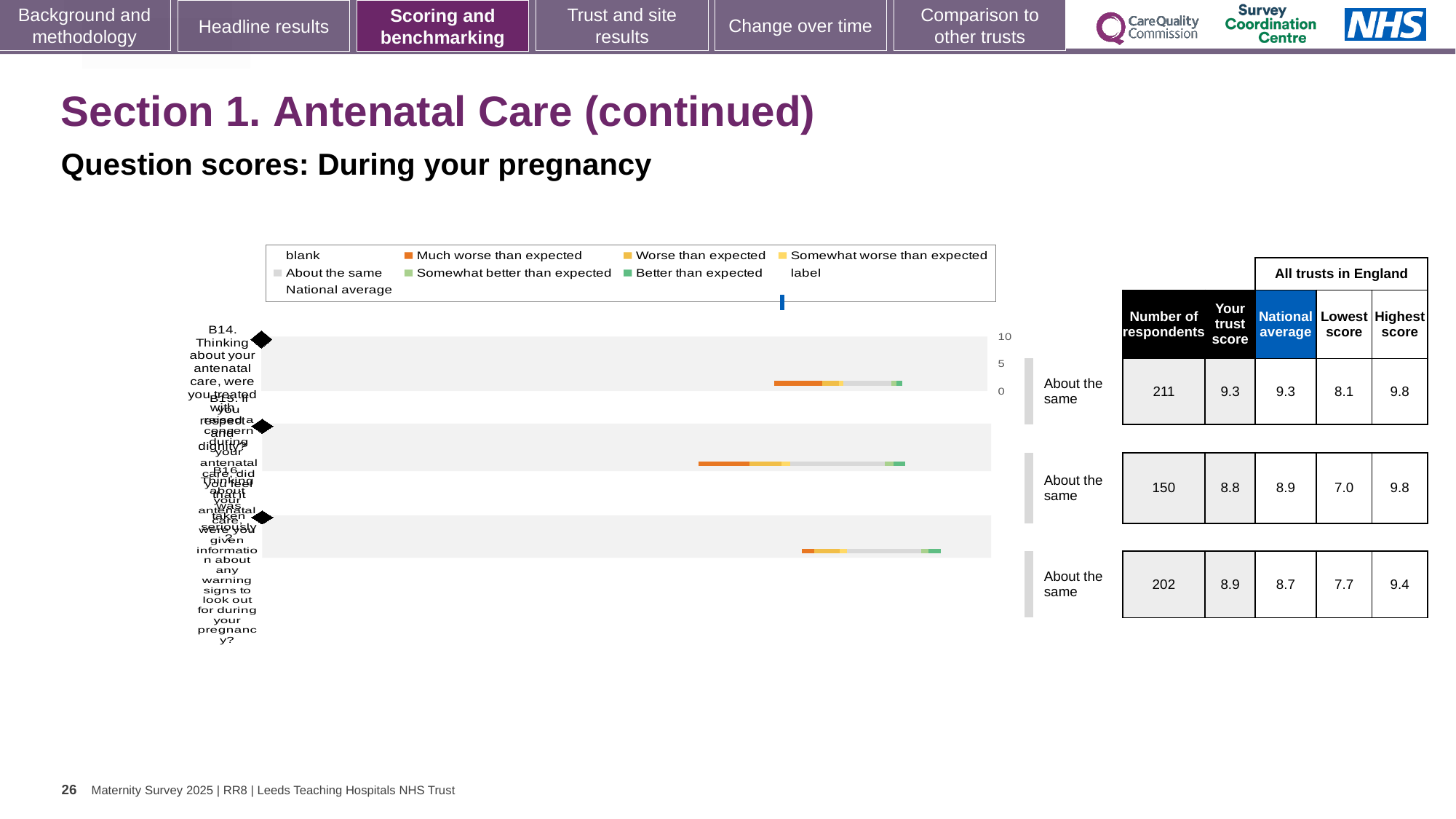
What kind of chart is shown on the slide? bar chart What is the national average for question B14? 9.3 What colour does the legend use for 'Much worse than expected'? orange What is the lowest score shown for the second question row in the table? 7.0 What is the difference between the highest score and the lowest score for question B14? 1.7 Which question row has the highest number of respondents? B14 (211) What is the 'Your trust score' for question B14 in the table beside the chart? 9.3 Which question row has the lowest 'Lowest score' value? the second row (7.0) How many question bars are plotted in the chart? 3 How many respondents are listed for question B14? 211 What benchmark category is shown next to the bar for question B14? About the same For the third question row, which is larger: the trust score or the national average? Your trust score (8.9)